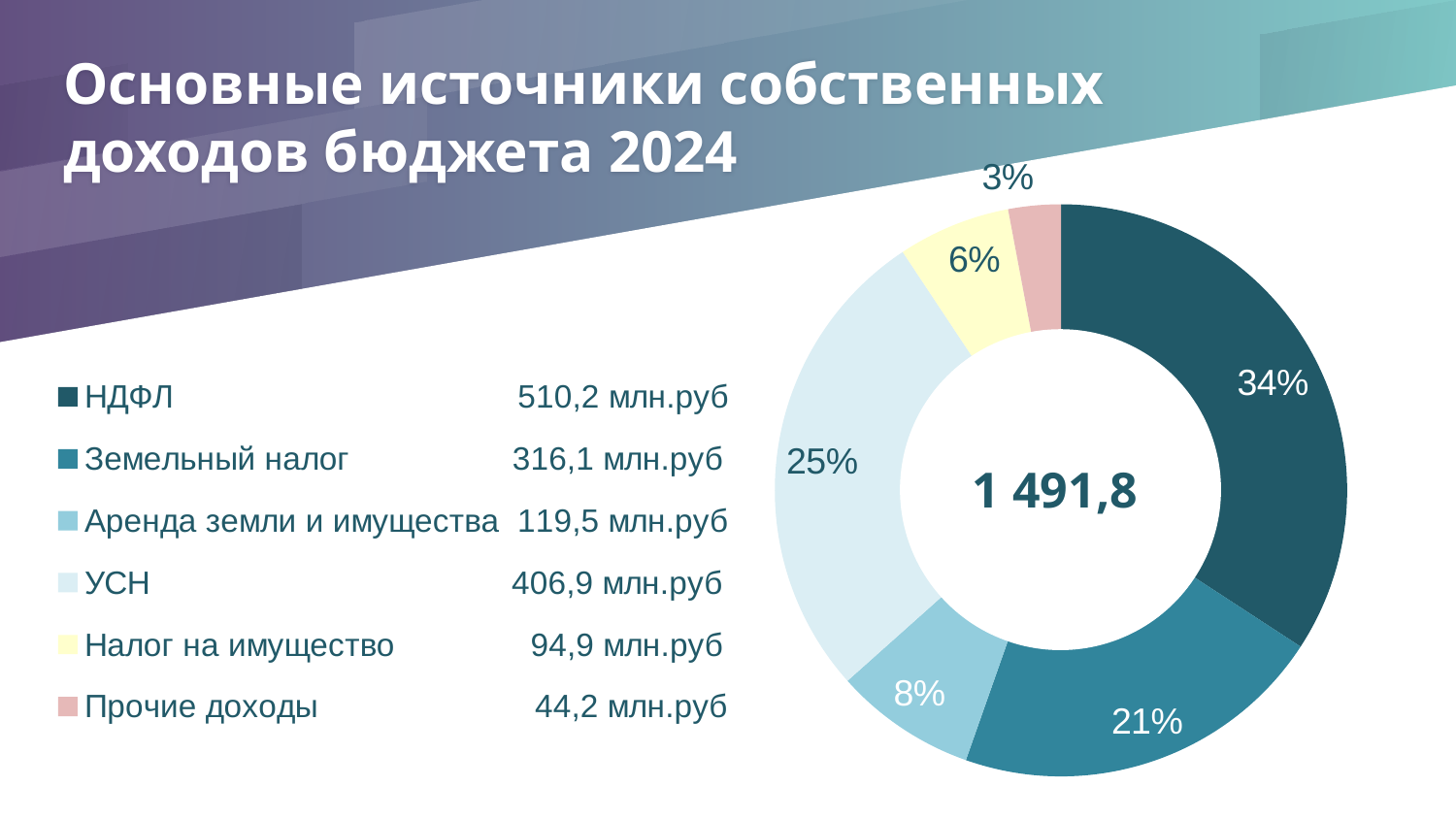
What percentage share of the chart does Аренда земли и имущества have? 8% What is the title of the slide? Основные источники собственных доходов бюджета 2024 Which category has the smallest value? Прочие доходы Which category has the largest value? НДФЛ What percentage share of the chart does УСН have? 25% What kind of chart is shown on the slide? pie chart What total value is shown in the centre of the chart? 1 491,8 What is the value for НДФЛ? 510,2 млн.руб What is the value for Налог на имущество? 94,9 млн.руб Which is larger, УСН or Земельный налог? УСН What is the difference between the values for НДФЛ and Земельный налог? 194,1 млн.руб How many categories are shown in the chart? 6